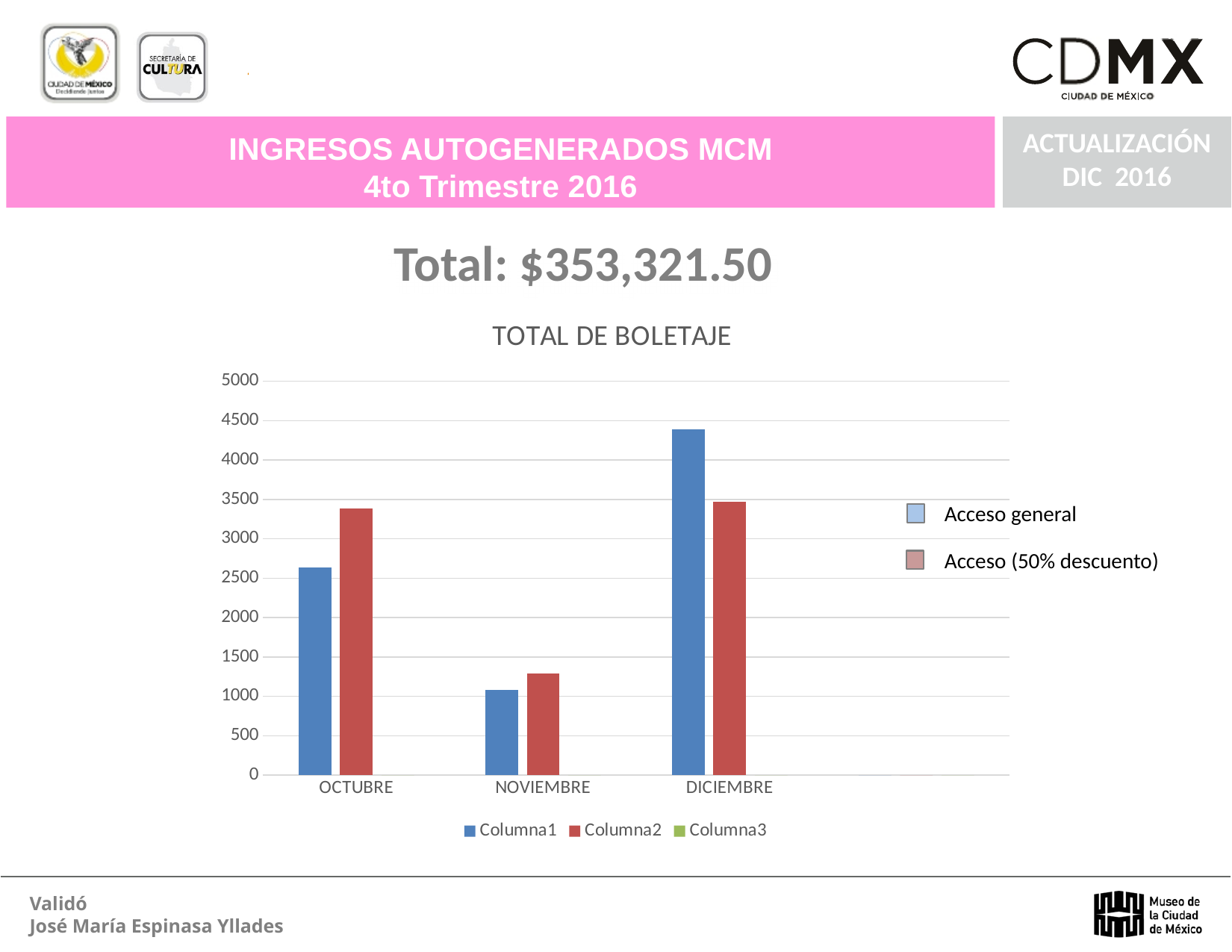
Is the Columna1 (blue) value for DICIEMBRE greater or less than 4000? greater Is the Columna2 (red) value for OCTUBRE greater or less than 3000? greater In which month is the Columna1 (blue) bar the highest? DICIEMBRE Is the Columna1 (blue) value for NOVIEMBRE greater or less than 1500? less For OCTUBRE, which bar is taller, Columna1 (blue) or Columna2 (red)? Columna2 For DICIEMBRE, which bar is taller, Columna1 (blue) or Columna2 (red)? Columna1 What kind of chart is shown on the slide? Bar chart How many months (categories) are shown on the x axis of the chart? 3 How many series does the legend below the chart list? 3 What is the title of the chart? TOTAL DE BOLETAJE In which month is the Columna2 (red) bar the lowest? NOVIEMBRE Which colour does the legend box to the right of the chart assign to 'Acceso general'? Blue